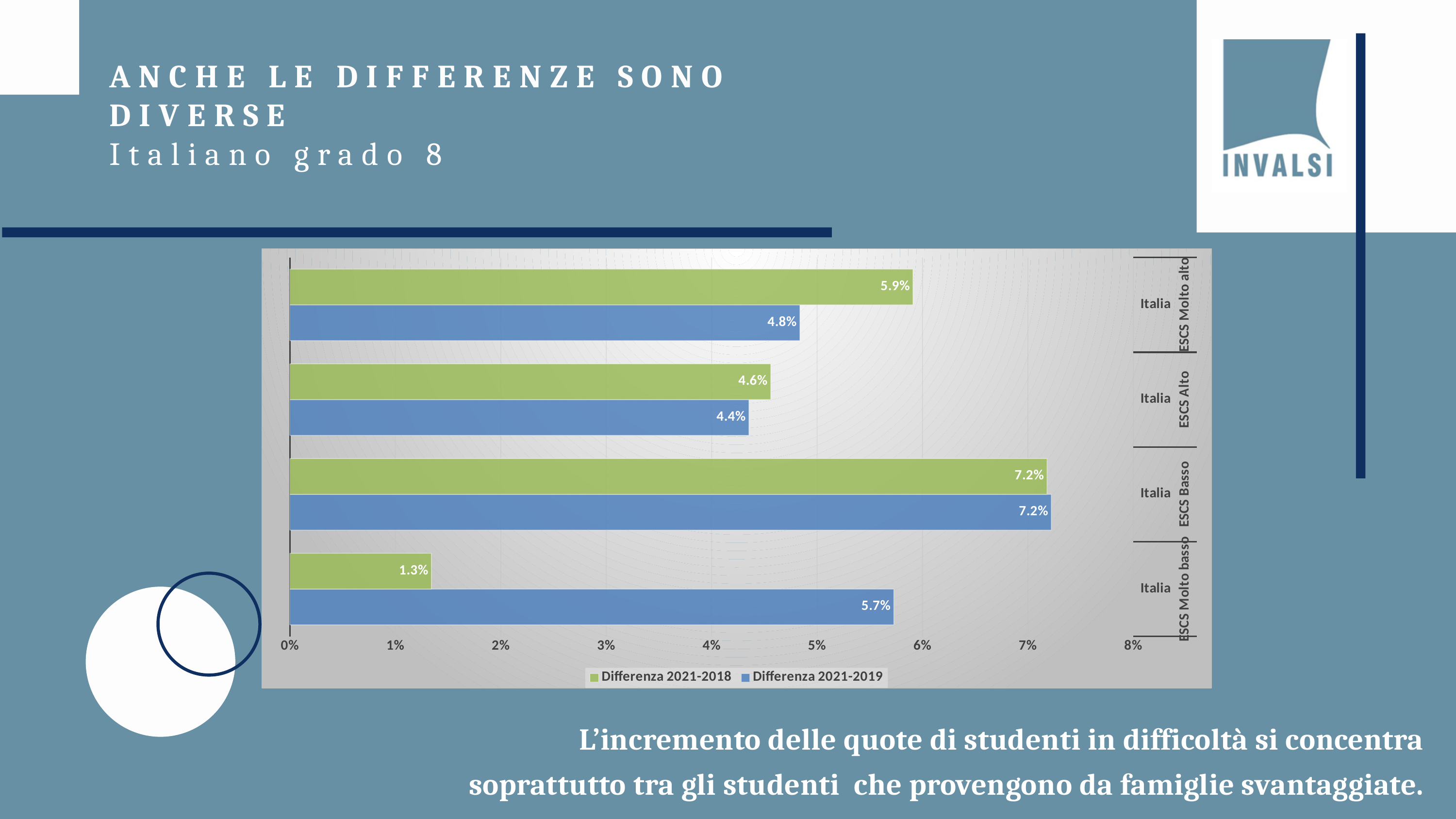
What is the value of Differenza 2021-2018 for ESCS Molto alto? 5.9% What kind of chart is shown on the slide? Bar chart What is the value of Differenza 2021-2019 for ESCS Molto basso? 5.7% How many ESCS categories are shown in the chart? 4 What is the value of Differenza 2021-2018 for ESCS Molto basso? 1.3% For ESCS Molto alto, which is larger: Differenza 2021-2018 or Differenza 2021-2019? Differenza 2021-2018 Which colour represents Differenza 2021-2019 in the chart? Blue What is the value of Differenza 2021-2019 for ESCS Alto? 4.4% Which category has the highest value for Differenza 2021-2018? ESCS Basso What is the difference between Differenza 2021-2019 and Differenza 2021-2018 for ESCS Molto basso? 4.4% Which category has the lowest value for Differenza 2021-2018? ESCS Molto basso How many series does the legend list? 2